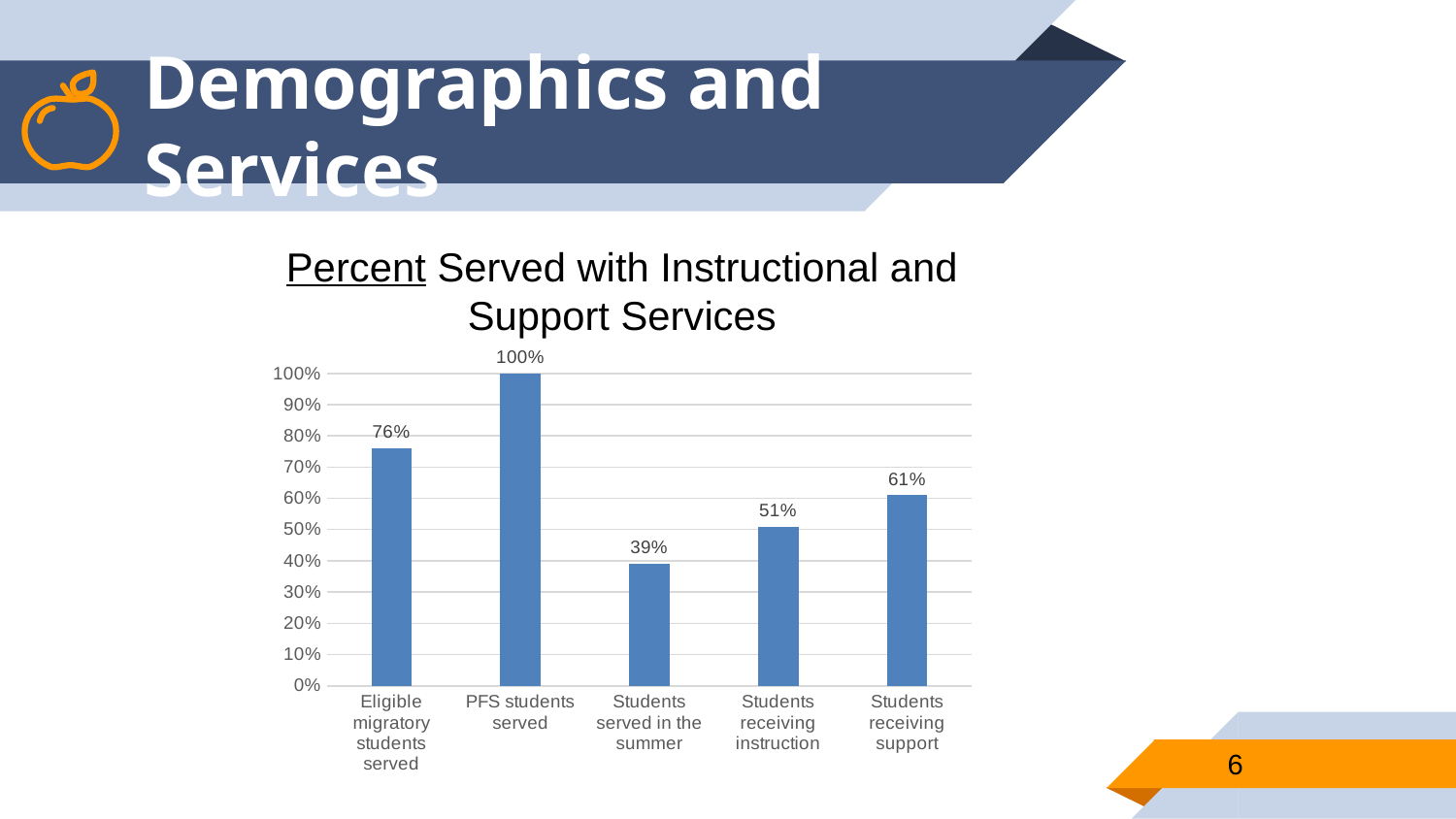
What is the difference between the values for Students receiving support and Students served in the summer? 22% Is the value for Students receiving instruction greater or less than 60%? less How many categories are shown on the x axis? 5 What kind of chart is shown on the slide? bar chart What is the value for Eligible migratory students served? 76% Which is larger, the value for Eligible migratory students served or the value for Students receiving support? Eligible migratory students served What is the difference between the values for PFS students served and Students receiving instruction? 49% Which category has the highest value? PFS students served What is the value for Students receiving support? 61% What is the value for Students served in the summer? 39% Which category has the lowest value? Students served in the summer What is the title of the chart? Percent Served with Instructional and Support Services